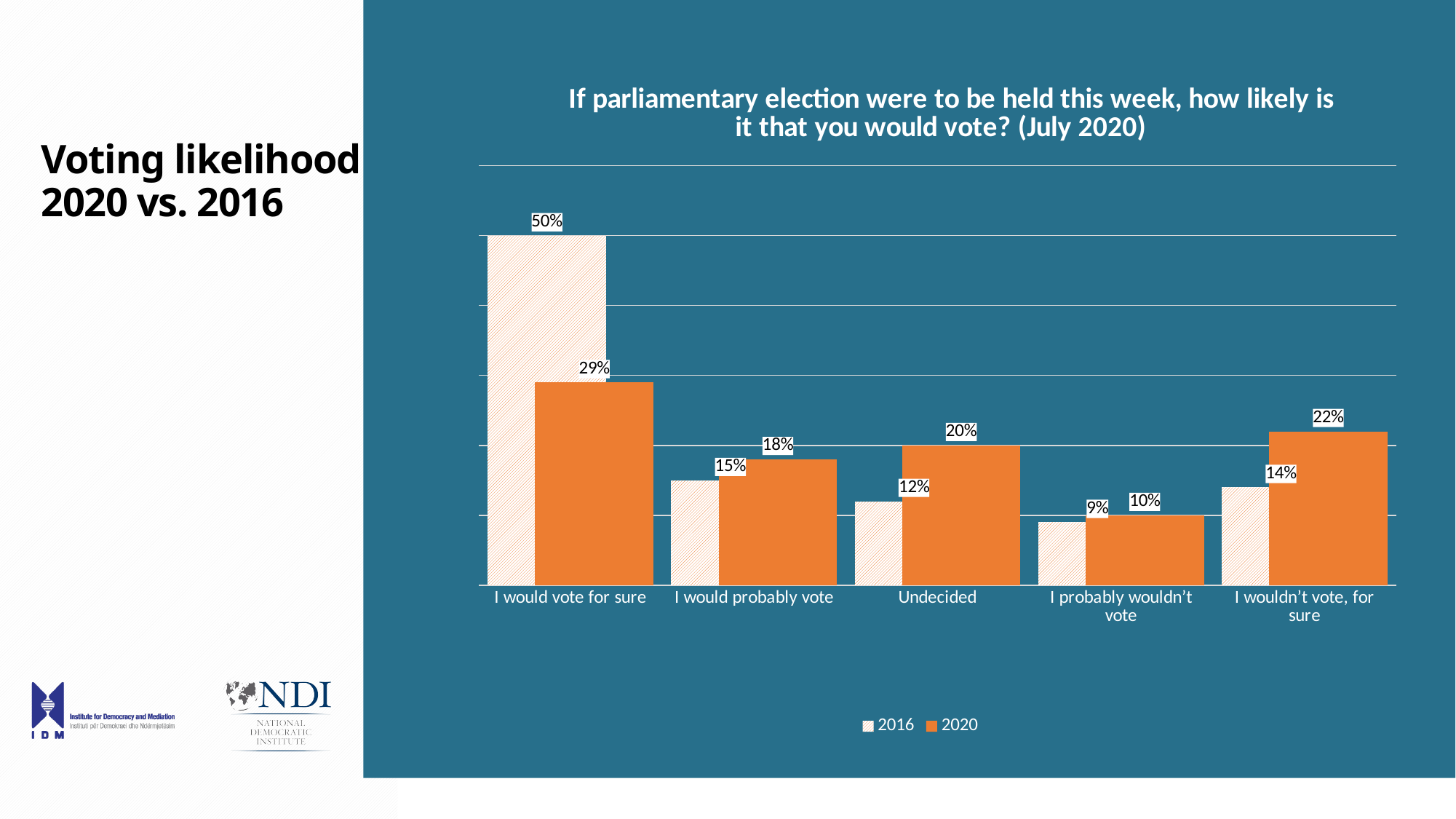
What is the 2020 value for "Undecided"? 20% How many series does the legend list? 2 Which is larger for "I wouldn't vote, for sure": the 2016 value or the 2020 value? 2020 What is the 2016 value for "I would vote for sure"? 50% Which category has the highest 2020 value? I would vote for sure Which series is shown in solid orange? 2020 What is the difference between the 2016 and 2020 values for "I would vote for sure"? 21% Which category has the lowest 2016 value? I probably wouldn't vote How many categories are shown on the x axis? 5 What kind of chart is shown on the slide? Bar chart What is the 2020 value for "I would vote for sure"? 29% What is the 2016 value for "I probably wouldn't vote"? 9%